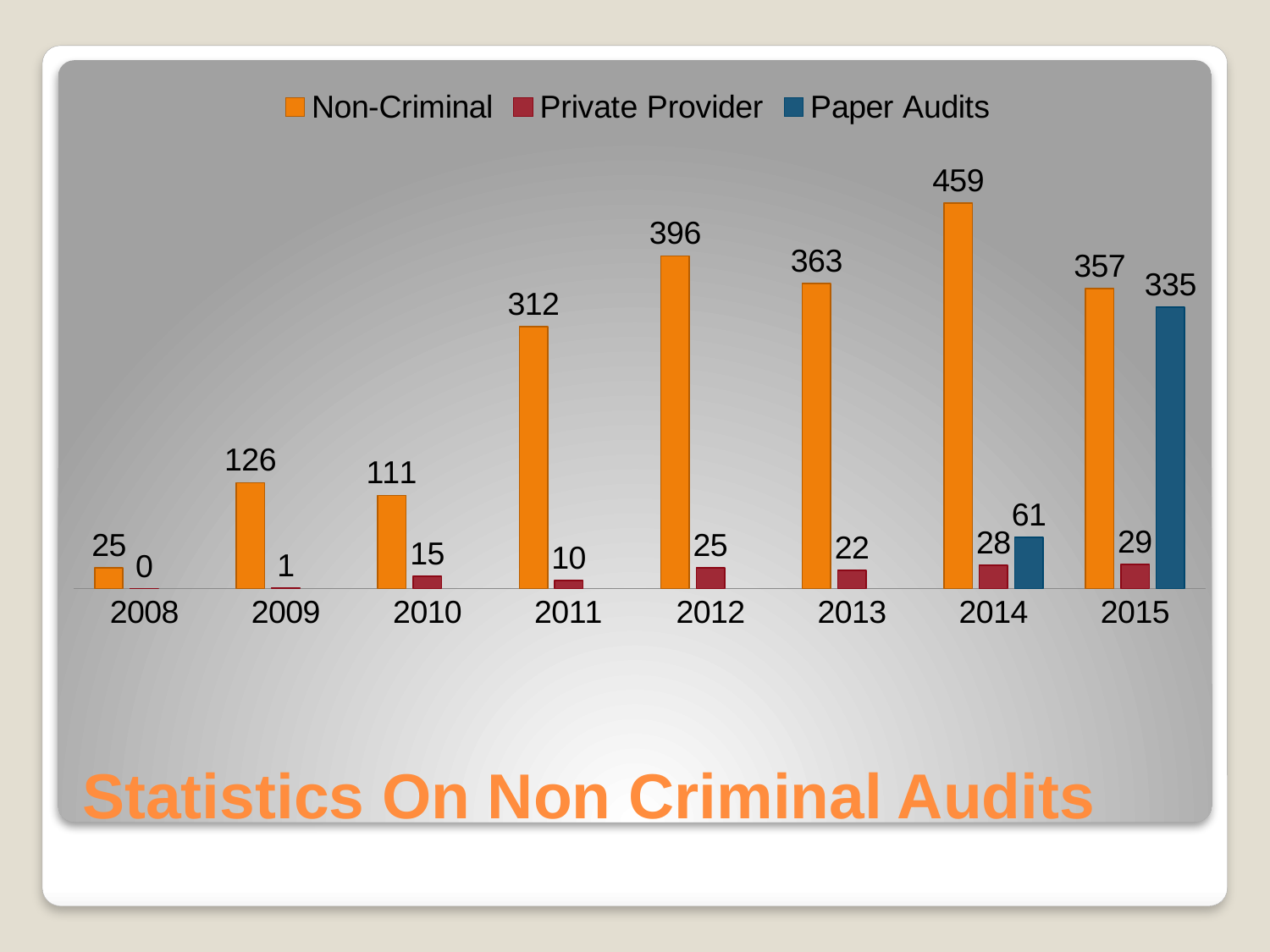
How many series does the legend list? 3 What is the title of the slide? Statistics On Non Criminal Audits What is the Private Provider value for 2012? 25 How many years are shown on the x axis? 8 Which year has the lowest Non-Criminal value? 2008 What is the Non-Criminal value for 2011? 312 What is the Non-Criminal value for 2014? 459 What kind of chart is shown on the slide? Bar chart Which is larger, the Non-Criminal value for 2009 or for 2010? 2009 What is the difference between the Non-Criminal values for 2014 and 2015? 102 Which year has the highest Non-Criminal value? 2014 What is the Paper Audits value for 2015? 335